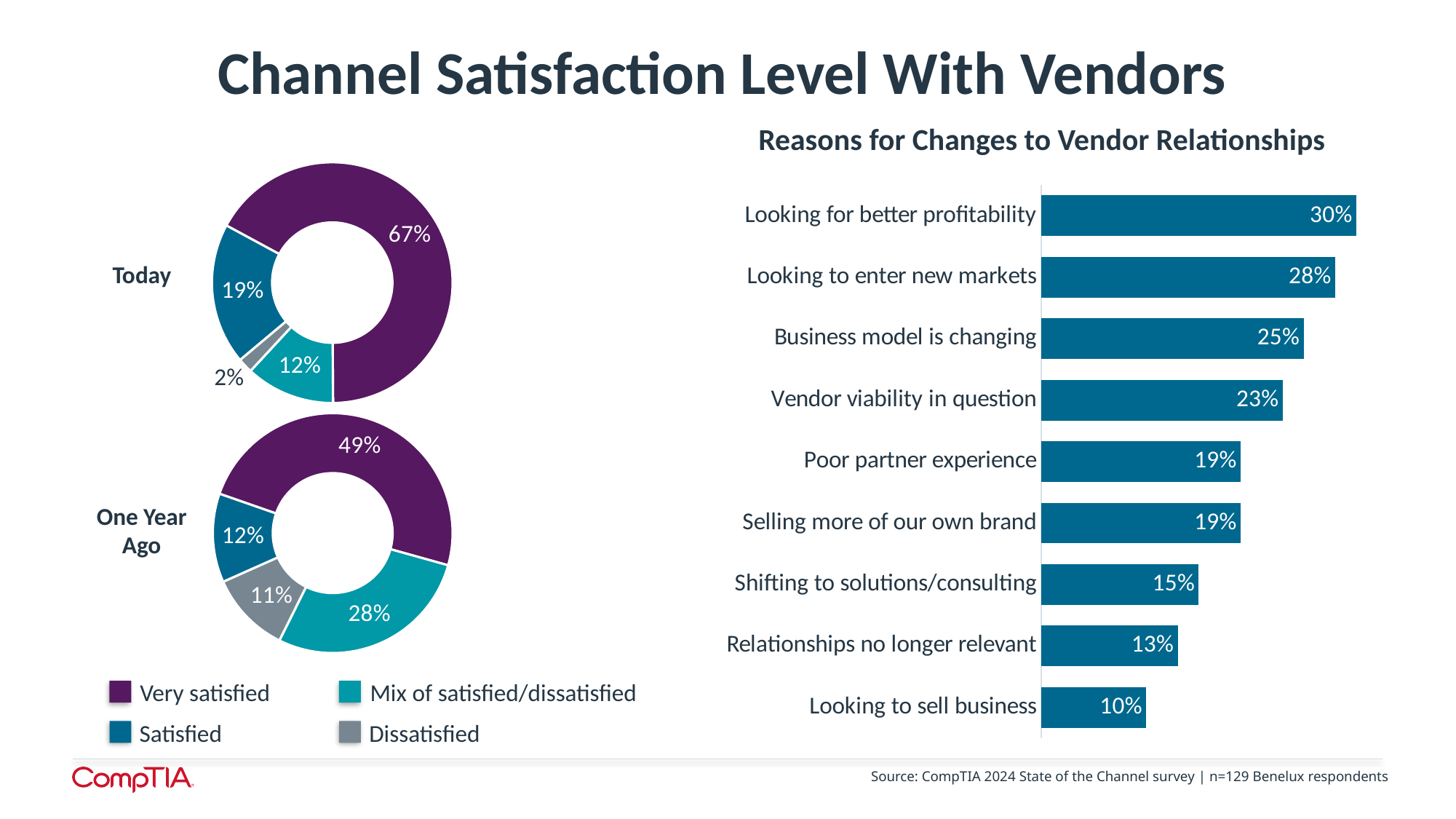
In the 'One Year Ago' donut chart, what percentage is Mix of satisfied/dissatisfied? 28% In the 'Reasons for Changes to Vendor Relationships' chart, which reason has the lowest value? Looking to sell business What is the difference between the Very satisfied share in the 'Today' donut and the Very satisfied share in the 'One Year Ago' donut? 18% In the 'Reasons for Changes to Vendor Relationships' chart, what is the value for 'Vendor viability in question'? 23% How many categories does the legend for the donut charts list? 4 What kind of chart is 'Reasons for Changes to Vendor Relationships'? Bar chart In the 'Reasons for Changes to Vendor Relationships' chart, what is the difference between 'Looking for better profitability' and 'Looking to enter new markets'? 2% In the 'Reasons for Changes to Vendor Relationships' chart, which reason has the highest value? Looking for better profitability In the 'Today' donut chart, what percentage is Dissatisfied? 2% How many reasons are listed in the 'Reasons for Changes to Vendor Relationships' chart? 9 In the 'Today' donut chart, what percentage is Very satisfied? 67% In the 'One Year Ago' donut chart, which is larger: Satisfied or Dissatisfied? Satisfied